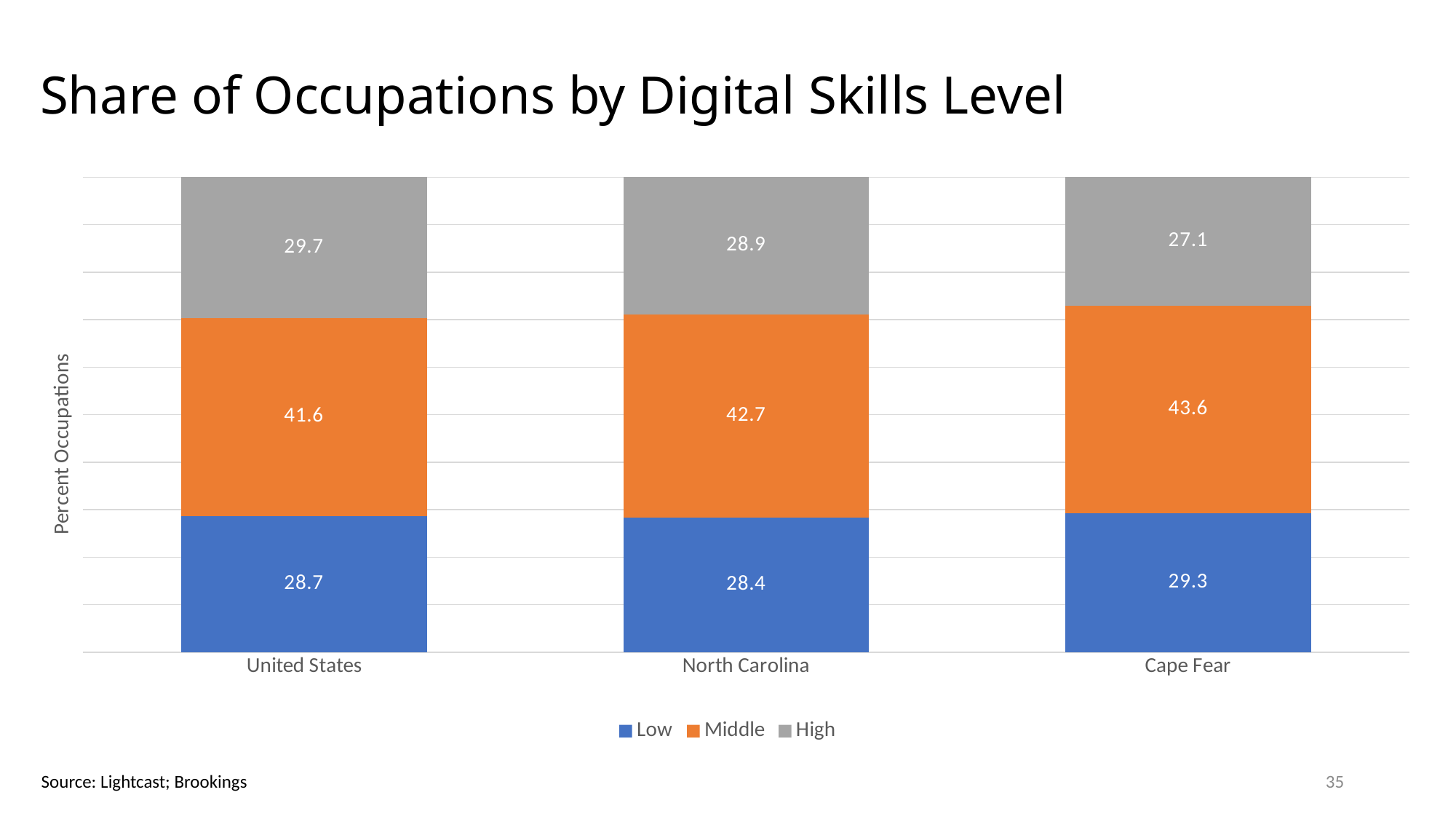
Which category has the highest value for Middle? Cape Fear What is the title of the chart? Share of Occupations by Digital Skills Level What is the difference between the Middle values for Cape Fear and the United States? 2.0 Which is larger, the High value for North Carolina or the High value for Cape Fear? North Carolina What is the value for Low in North Carolina? 28.4 What is the total of the stacked bar for North Carolina? 100.0 What is the value for Middle in Cape Fear? 43.6 How many series does the legend list? 3 What kind of chart is shown on the slide? Stacked bar chart Which category has the lowest value for High? Cape Fear How many categories are shown on the x axis? 3 What is the value for High in the United States? 29.7